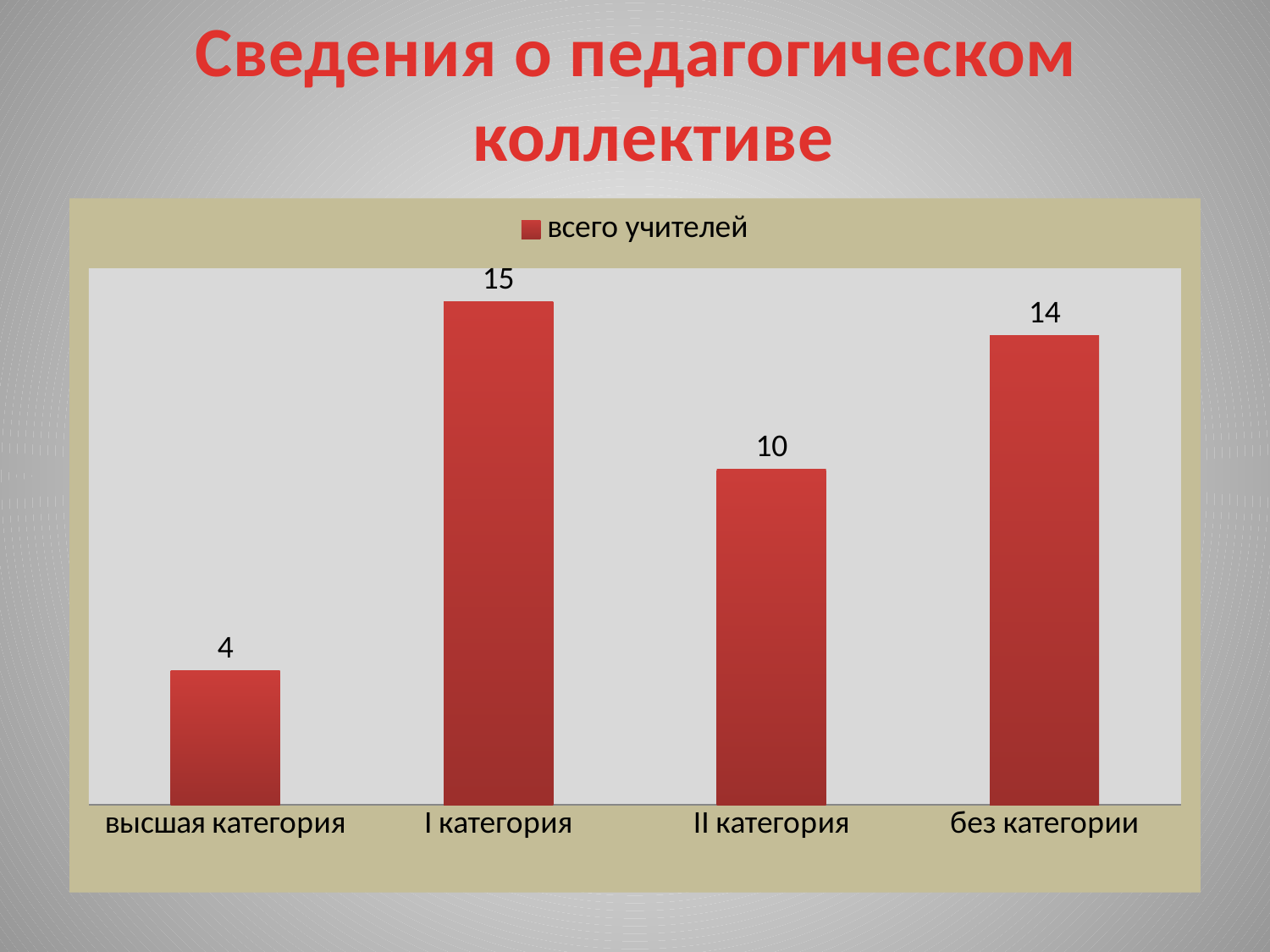
Which is larger, the value for II категория or the value for без категории? без категории Which category has the lowest value? высшая категория What is the difference between the values for I категория and II категория? 5 How many categories are shown on the chart? 4 What is the difference between the values for без категории and высшая категория? 10 What is the value for высшая категория? 4 What is the value for I категория? 15 Which category has the highest value? I категория What series name does the legend show? всего учителей What is the value for без категории? 14 What is the value for II категория? 10 What kind of chart is shown on the slide? bar chart